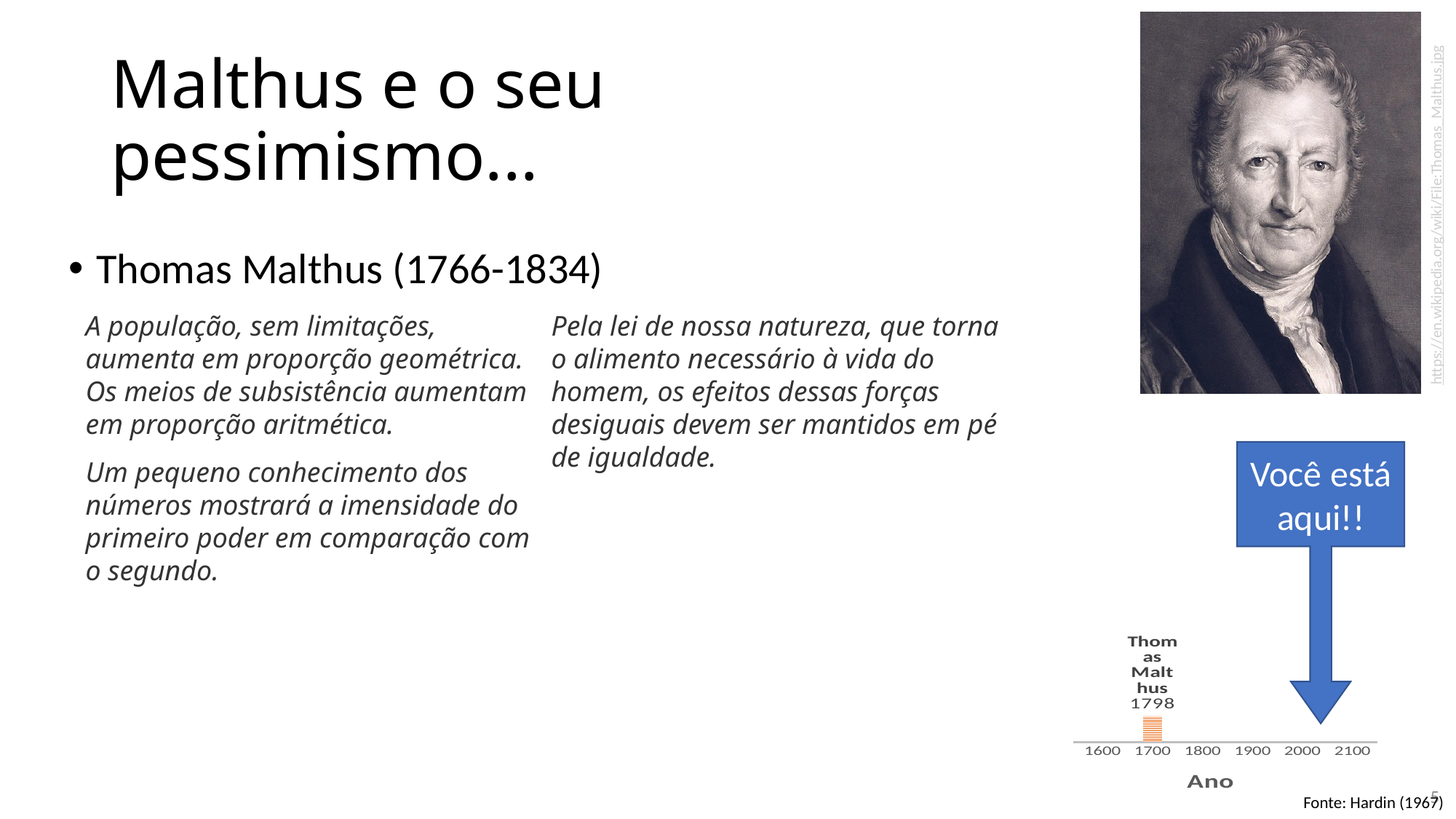
How many tick labels are shown on the x axis of the chart at the bottom right? 6 What is the first (leftmost) tick label on the x axis of the chart at the bottom right? 1600 Whose name is printed in the label above the bar in the chart at the bottom right? Thomas Malthus Is the bar in the chart at the bottom right positioned before or after the 1800 tick on the x axis? before What kind of chart is shown at the bottom right of the slide? bar chart How many bars are plotted in the chart at the bottom right? 1 What year is printed in the label above the bar in the chart at the bottom right? 1798 What is the last (rightmost) tick label on the x axis of the chart at the bottom right? 2100 What is the title of the x axis of the chart at the bottom right? Ano